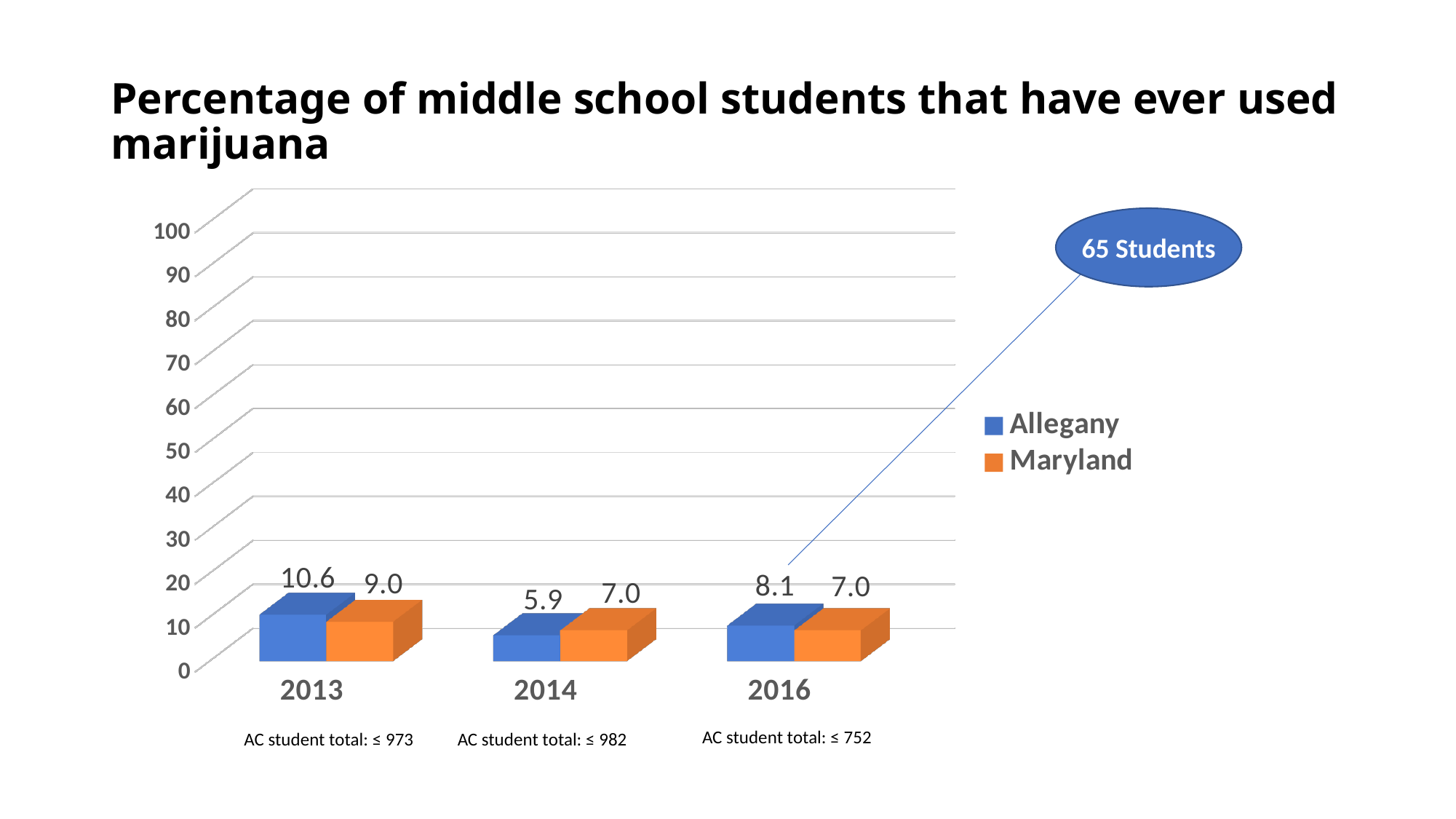
In which year is the Allegany value lowest? 2014 Which is larger in 2014, the Allegany value or the Maryland value? Maryland Which colour represents Maryland in the chart? orange What is the value for Allegany in 2013? 10.6 What is the value for Allegany in 2016? 8.1 What is the difference between the Allegany and Maryland values in 2013? 1.6 In which year is the Allegany value highest? 2013 How many years are shown on the x axis? 3 How many series does the legend list? 2 Is the value for Allegany in 2013 greater or less than 20? less What kind of chart is shown on the slide? bar chart What is the value for Maryland in 2014? 7.0